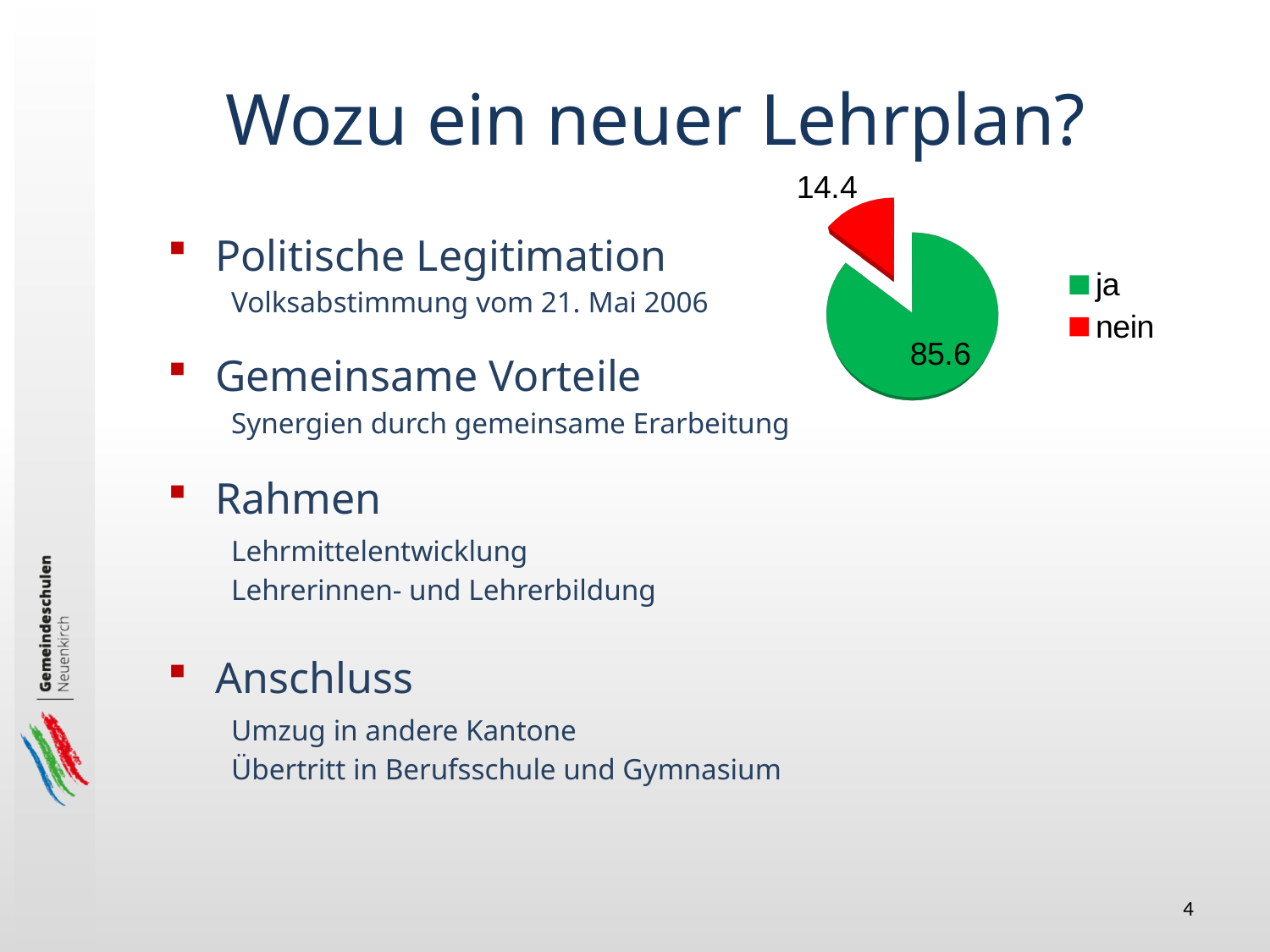
What is the value for "ja" in the pie chart? 85.6 What kind of chart is shown on the slide? pie chart What is the difference between the values for "ja" and "nein"? 71.2 How many entries does the legend list? 2 What colour is the "ja" slice in the pie chart? green Which category has the smallest slice in the pie chart? nein What colour is the "nein" slice in the pie chart? red Which category has the largest slice in the pie chart? ja What is the value for "nein" in the pie chart? 14.4 How many slices does the pie chart have? 2 Which is larger, the value for "ja" or the value for "nein"? ja